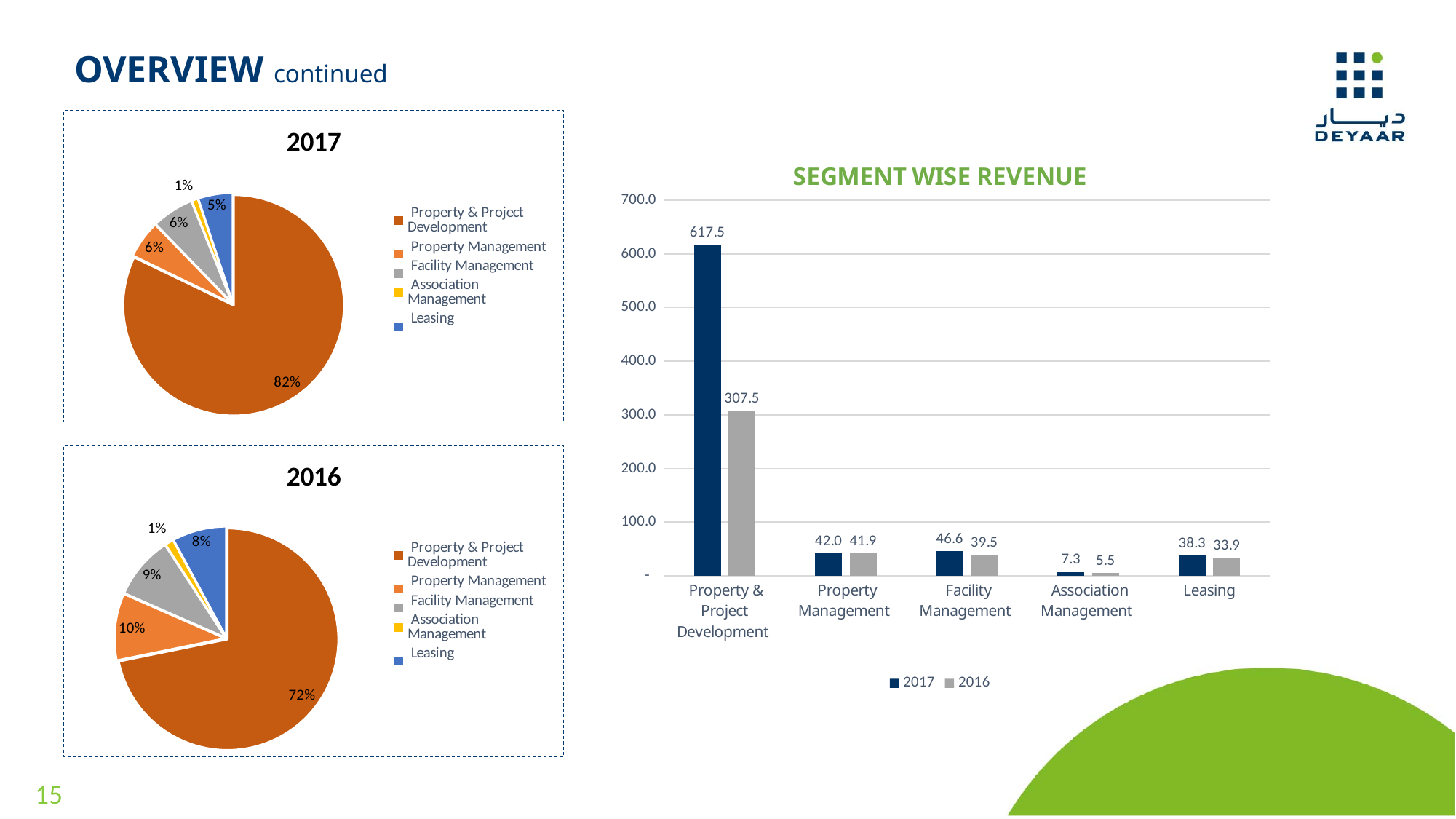
In the 2017 pie chart, what share does Property & Project Development have? 82% In the Segment Wise Revenue bar chart, how many series does the legend list? 2 In the 2016 pie chart, which segment has the smallest share? Association Management In the Segment Wise Revenue bar chart, what is the 2017 value for Property & Project Development? 617.5 In the Segment Wise Revenue bar chart, is the 2017 value for Facility Management larger or smaller than the 2017 value for Leasing? larger In the Segment Wise Revenue bar chart, how many segments are shown on the x axis? 5 What kind of chart is the Segment Wise Revenue chart? bar chart In the Segment Wise Revenue bar chart, what is the difference between the 2017 and 2016 values for Property & Project Development? 310.0 In the Segment Wise Revenue bar chart, which segment has the lowest 2016 value? Association Management In the 2016 pie chart, what share does Leasing have? 8% In the Segment Wise Revenue bar chart, what is the 2016 value for Association Management? 5.5 In the Segment Wise Revenue bar chart, which segment has the highest 2017 value? Property & Project Development